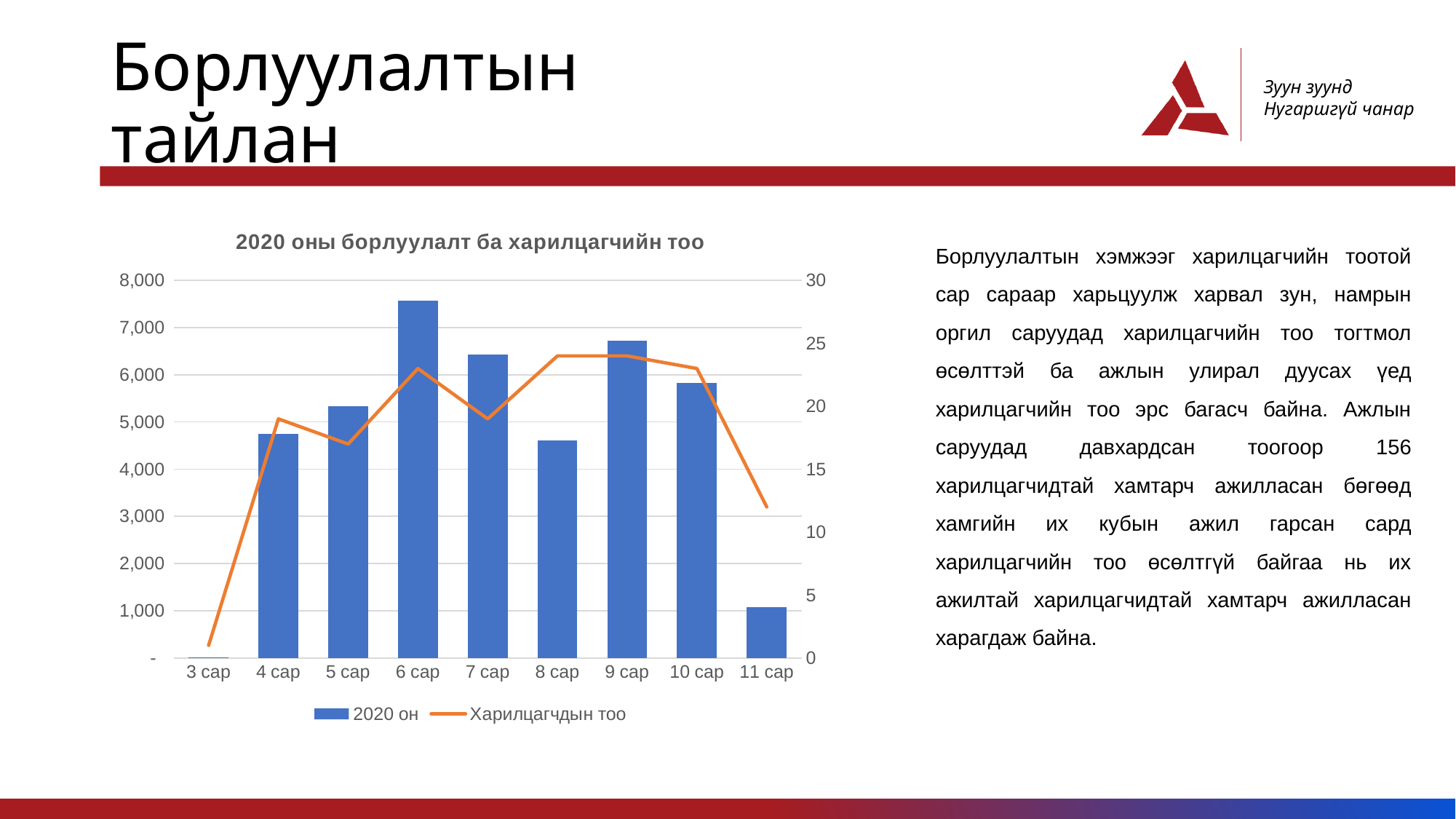
Which series is drawn as a line in the chart? Харилцагчдын тоо Which is larger, the 2020 он bar for 9 сар or for 10 сар? 9 сар Which month has the lowest bar for the 2020 он series? 3 сар How many series does the chart legend list? 2 What is the title of the chart? 2020 оны борлуулалт ба харилцагчийн тоо Is the 2020 он bar for 11 сар greater or less than 2,000? less How many months (categories) are shown on the x axis of the chart? 9 Does the Харилцагчдын тоо line rise or fall between 10 сар and 11 сар? fall Is the 2020 он bar for 8 сар greater or less than 5,000? less Is the 2020 он bar for 6 сар greater or less than 7,000? greater Which month has the highest bar for the 2020 он series? 6 сар